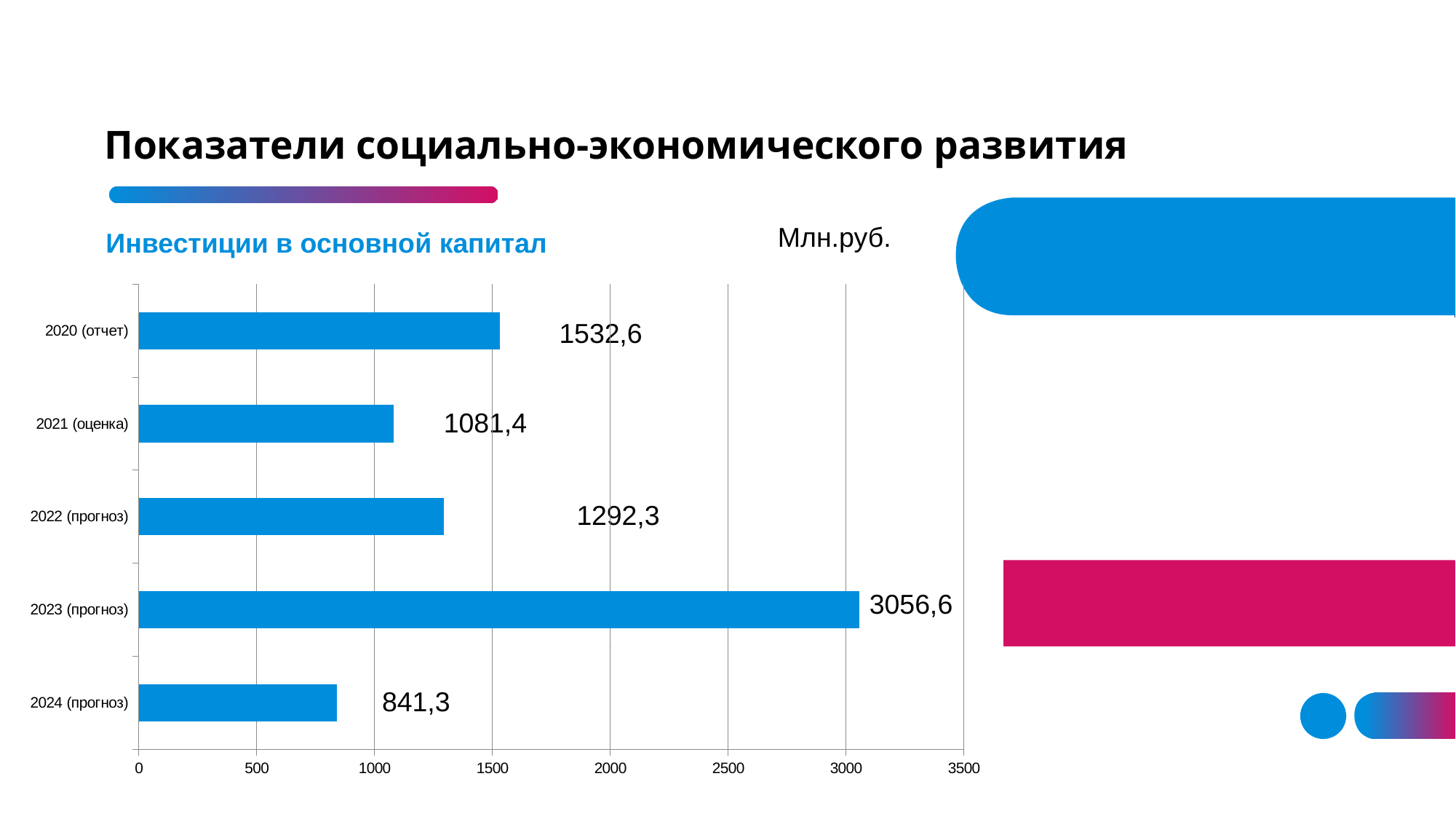
What is the value for 2021 (оценка)? 1081,4 Is the value for 2024 (прогноз) greater or less than 1000? less Which category has the lowest value? 2024 (прогноз) What is the difference between the values for 2020 (отчет) and 2021 (оценка)? 451,2 What kind of chart is shown on the slide? bar chart Which category has the highest value? 2023 (прогноз) What is the value for 2020 (отчет)? 1532,6 What is the value for 2024 (прогноз)? 841,3 What is the value for 2023 (прогноз)? 3056,6 How many categories are shown in the chart? 5 Which is larger, the value for 2022 (прогноз) or the value for 2021 (оценка)? 2022 (прогноз) What is the difference between the values for 2023 (прогноз) and 2020 (отчет)? 1524